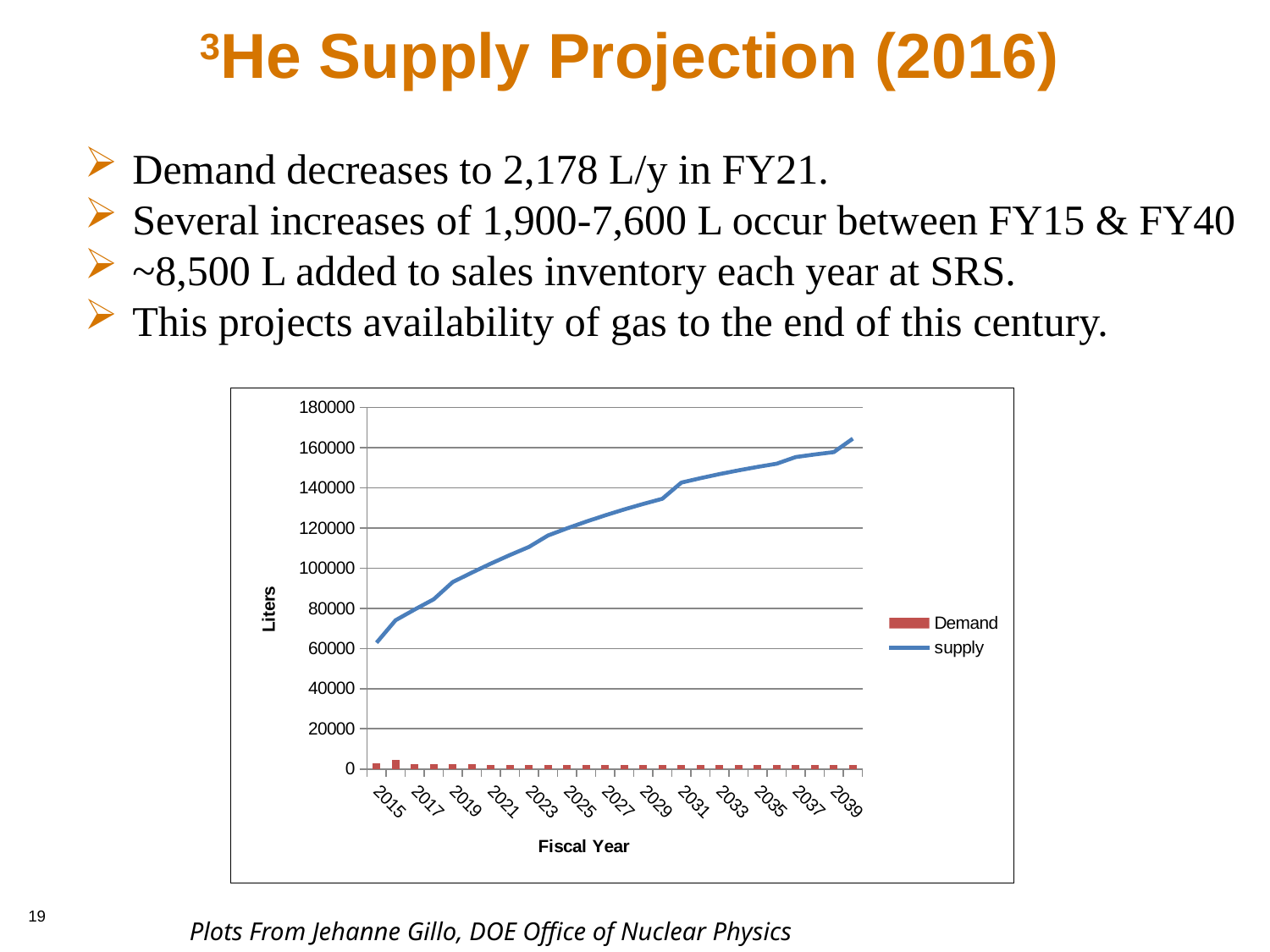
Does the supply series rise or fall across the fiscal years? Rises What is the label on the y axis? Liters What kind of chart is this? A combined bar and line chart In which fiscal year is supply lowest? 2015 Is the Demand value for 2015 greater or less than 20000? less Is the supply value for 2015 greater or less than 80000? less How many series does the legend list? 2 Is the supply value for 2027 greater or less than 120000? greater What are the two series named in the legend? Demand and supply In 2025, which is larger, supply or Demand? supply